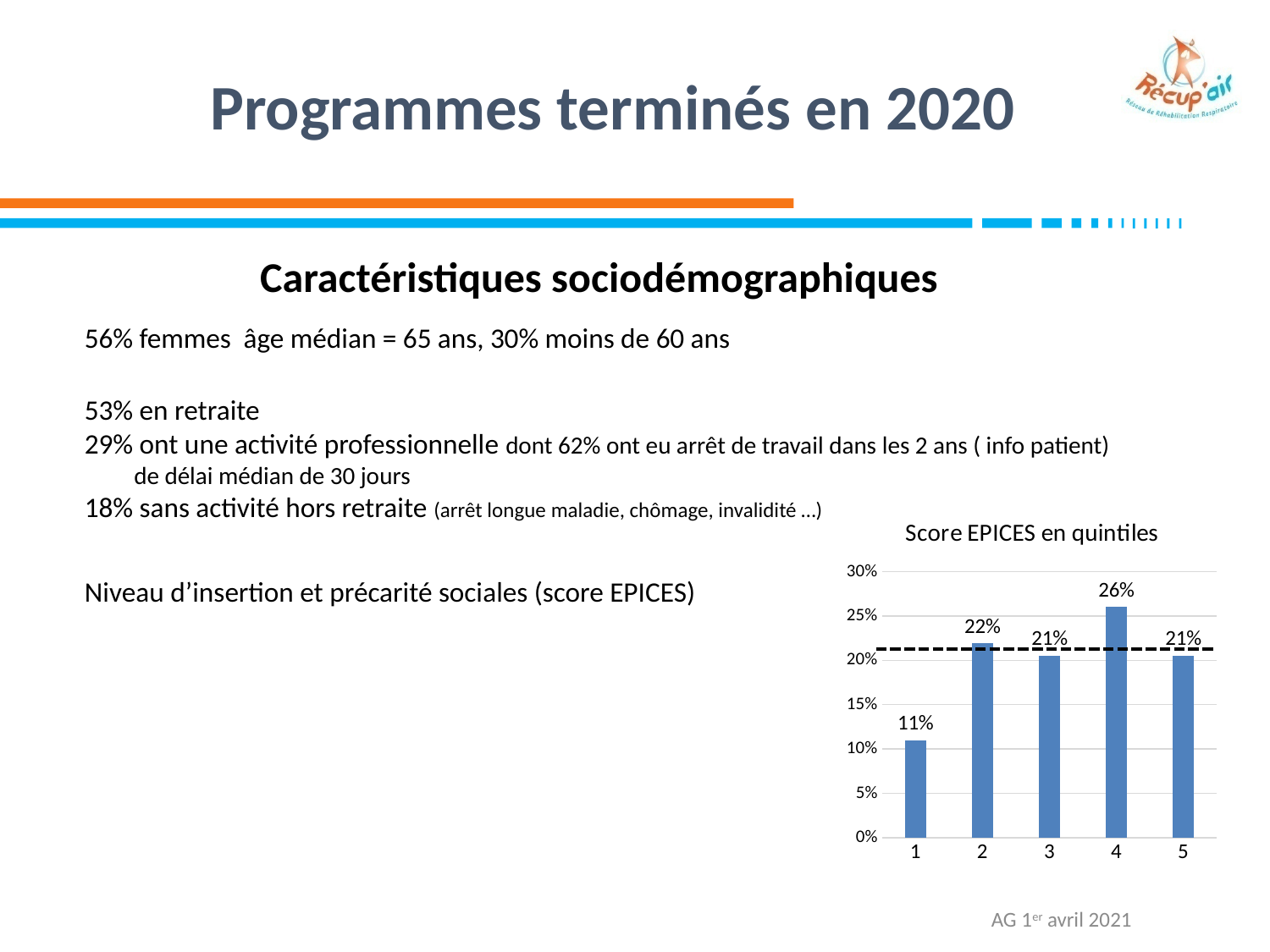
What kind of chart is the Score EPICES en quintiles chart? Bar chart What is the value for quintile 1 in the Score EPICES en quintiles chart? 11% What is the value for quintile 2 in the Score EPICES en quintiles chart? 22% What is the title of the chart on the slide? Score EPICES en quintiles Is the value for quintile 4 in the Score EPICES en quintiles chart greater or less than 25%? greater What is the highest value shown on the y axis of the Score EPICES en quintiles chart? 30% Which quintile has the lowest value in the Score EPICES en quintiles chart? 1 What is the value for quintile 4 in the Score EPICES en quintiles chart? 26% Which quintile has the highest value in the Score EPICES en quintiles chart? 4 Which is larger in the Score EPICES en quintiles chart, the value for quintile 2 or quintile 1? Quintile 2 How many quintiles (bars) are shown in the Score EPICES en quintiles chart? 5 What is the difference between the values for quintile 4 and quintile 1 in the Score EPICES en quintiles chart? 15%